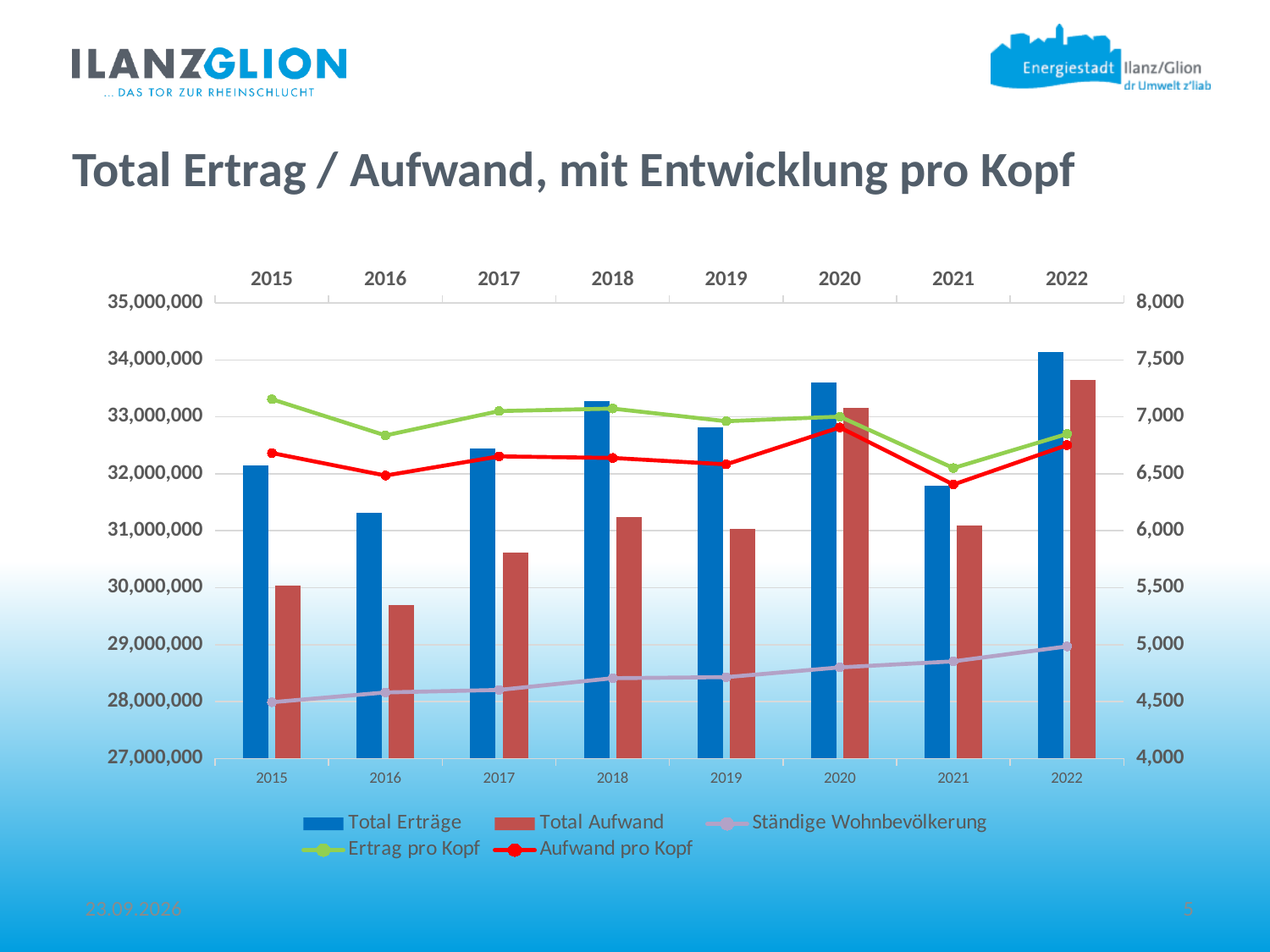
Which is larger in 2020, Total Erträge or Total Aufwand? Total Erträge Does the Ständige Wohnbevölkerung line rise or fall from 2015 to 2022? rise Is the value for Ertrag pro Kopf in 2015 greater or less than 7,000? greater In which year is Ertrag pro Kopf highest? 2015 What kind of chart is shown on the slide? Combined bar and line chart In which year is Total Aufwand lowest? 2016 Is the value for Total Erträge in 2020 greater or less than 33,000,000? greater In which year is Total Erträge highest? 2022 In which year is Aufwand pro Kopf lowest? 2021 How many years are shown on the x axis of the chart? 8 Is the value for Total Aufwand in 2016 greater or less than 30,000,000? less How many series does the chart legend list? 5